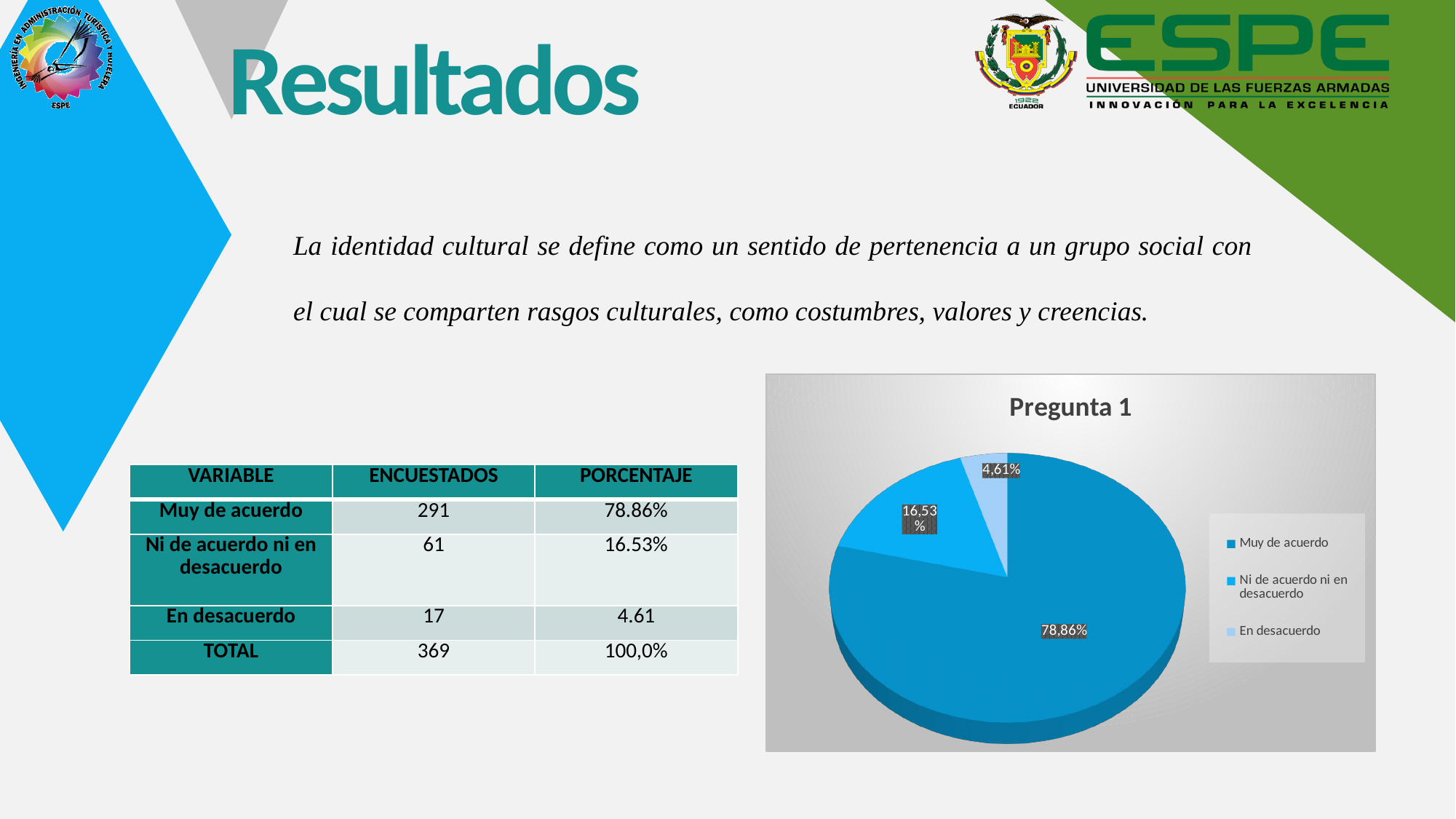
What percentage does the chart show for En desacuerdo? 4,61% How many entries does the chart legend list? 3 Which category has the smallest slice of the pie? En desacuerdo Which slice is larger, Ni de acuerdo ni en desacuerdo or En desacuerdo? Ni de acuerdo ni en desacuerdo Which category has the largest slice of the pie? Muy de acuerdo What is the title of the chart? Pregunta 1 How many slices does the pie chart have? 3 What percentage does the chart show for Muy de acuerdo? 78,86% What percentage does the chart show for Ni de acuerdo ni en desacuerdo? 16,53% Which legend entry is listed first in the chart legend? Muy de acuerdo What type of chart is shown on the slide? pie chart What is the difference in percentage points between Muy de acuerdo and Ni de acuerdo ni en desacuerdo? 62,33